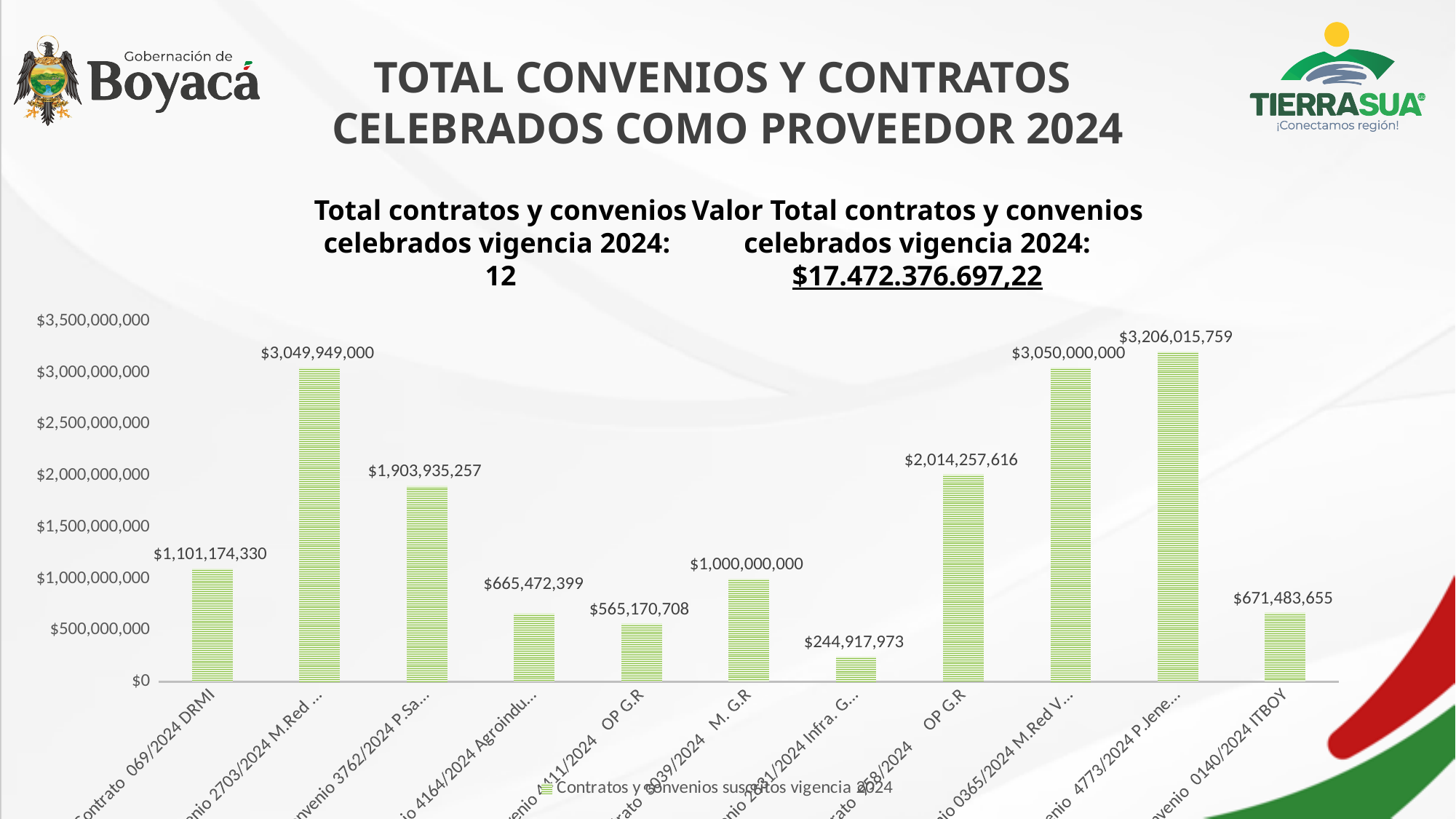
What is the difference between the value for Convenio 4773/2024 P.Jene... and the value for Convenio 0365/2024 M.Red V...? $156,015,759 What is the value shown for Contrato 069/2024 DRMI? $1,101,174,330 What is the value shown for Convenio 0140/2024 ITBOY? $671,483,655 Which contract or agreement has the highest value in the chart? Convenio 4773/2024 P.Jene... ($3,206,015,759) What type of chart is shown on the slide? Bar chart How many series does the chart legend list? 1 What is the legend entry shown below the chart? Contratos y convenios suscritos vigencia 2024 Which contract or agreement has the lowest value in the chart? Convenio 2831/2024 Infra. G... ($244,917,973) How many bars (contracts and agreements) are plotted in the chart? 11 Is the value for Convenio 4164/2024 Agroindu... greater or less than $500,000,000? greater Which is larger: the value for Contrato 069/2024 DRMI or the value for Convenio 0140/2024 ITBOY? Contrato 069/2024 DRMI